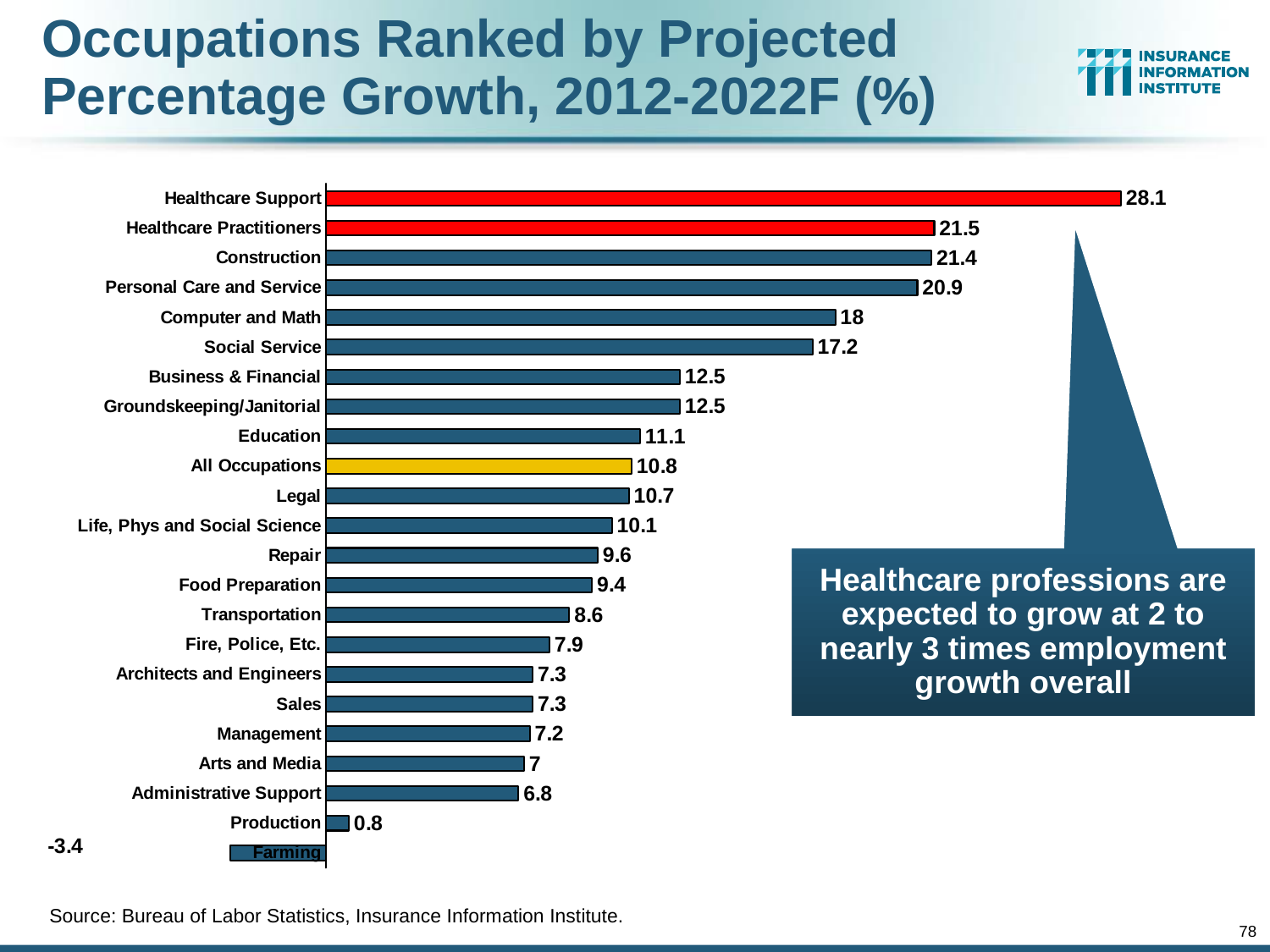
Which has a higher projected percentage growth, Social Service or Education? Social Service What is the projected percentage growth for All Occupations? 10.8 What is the difference between the projected growth for Healthcare Support and Healthcare Practitioners? 6.6 What is the projected percentage growth for Healthcare Support? 28.1 What is the projected percentage growth for Computer and Math? 18 How many occupation categories are shown in the chart? 23 Which bar in the chart is coloured yellow? All Occupations What type of chart is shown on the slide? Bar chart Which occupation has the highest projected percentage growth? Healthcare Support Which occupation has the lowest projected percentage growth? Farming What is the projected percentage growth for Farming? -3.4 What is the difference between the projected growth for Construction and All Occupations? 10.6